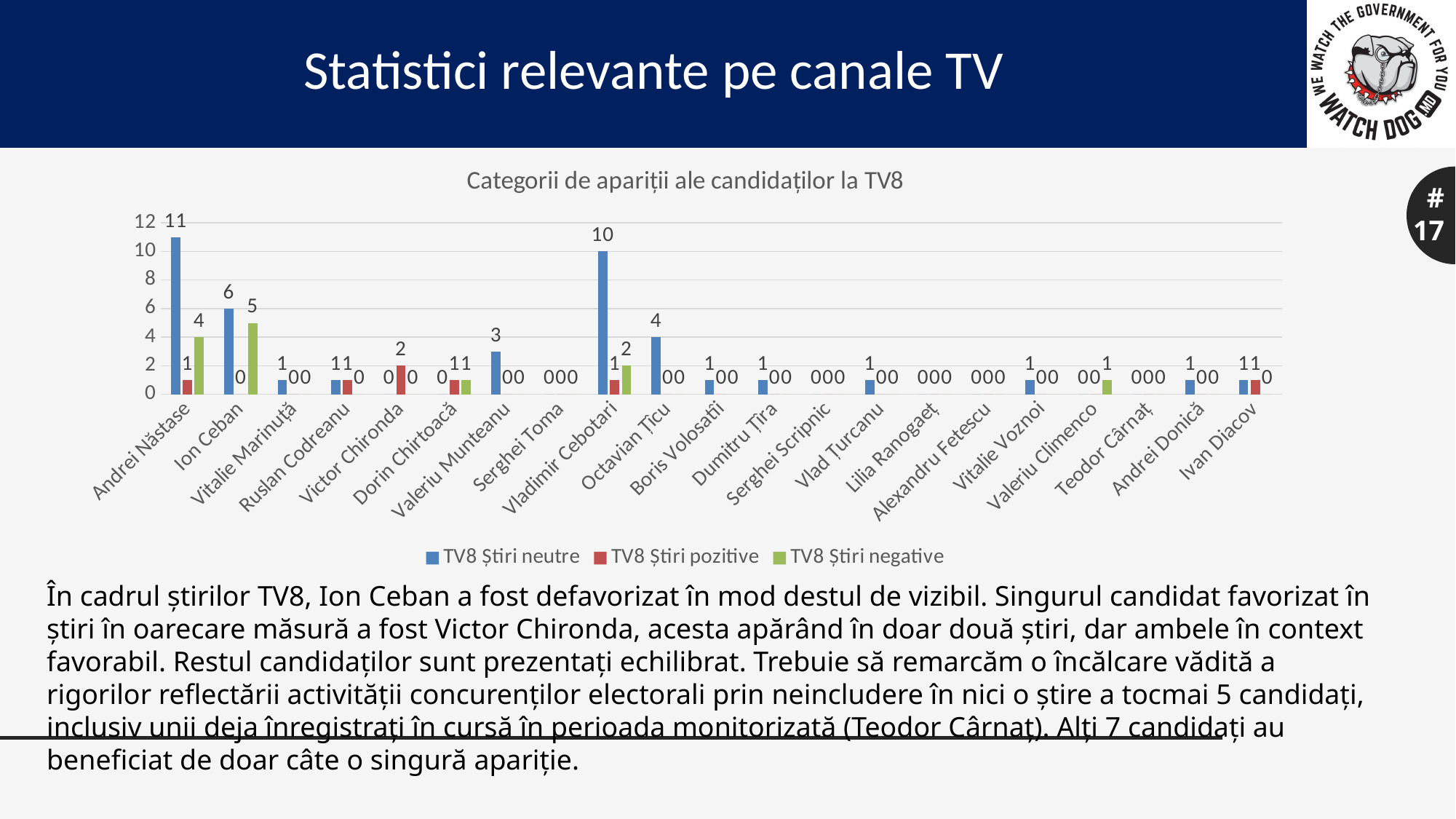
What is the difference between the TV8 Știri neutre values for Andrei Năstase and Vladimir Cebotari? 1 Which candidate has the highest value for TV8 Știri neutre? Andrei Năstase What kind of chart is shown on the slide? Bar chart Which is larger: TV8 Știri neutre for Ion Ceban or for Octavian Țîcu? Ion Ceban What is the value of TV8 Știri neutre for Vladimir Cebotari? 10 What is the value of TV8 Știri pozitive for Victor Chironda? 2 Which candidate has the highest value for TV8 Știri negative? Ion Ceban What is the value of TV8 Știri negative for Ion Ceban? 5 What is the title of the chart? Categorii de apariții ale candidaților la TV8 How many series does the legend list? 3 How many candidates are shown on the x axis of the chart? 21 What is the value of TV8 Știri neutre for Andrei Năstase? 11